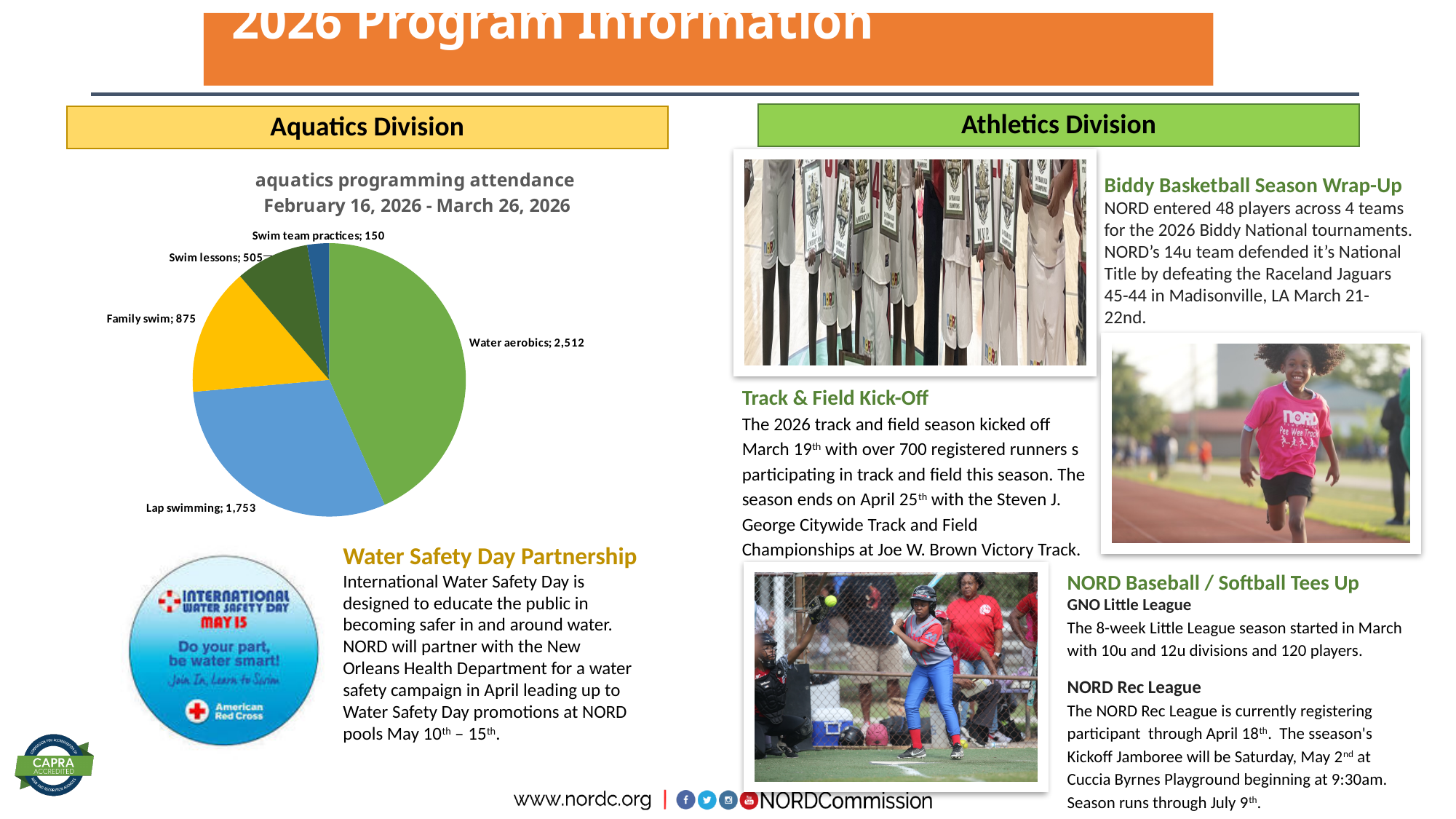
Which category has the lowest attendance in the aquatics programming attendance pie chart? Swim team practices What is the attendance value for Family swim in the pie chart? 875 What is the difference in attendance between Swim lessons and Swim team practices in the pie chart? 355 What is the attendance value for Water aerobics in the pie chart? 2,512 How many categories does the aquatics programming attendance pie chart show? 5 What is the attendance value for Lap swimming in the pie chart? 1,753 What is the attendance value for Swim team practices in the pie chart? 150 What kind of chart is shown under the Aquatics Division heading? Pie chart Which has higher attendance in the pie chart, Family swim or Swim lessons? Family swim Which category has the highest attendance in the aquatics programming attendance pie chart? Water aerobics What is the difference in attendance between Water aerobics and Lap swimming in the pie chart? 759 What is the title of the pie chart on the slide? aquatics programming attendance February 16, 2026 - March 26, 2026